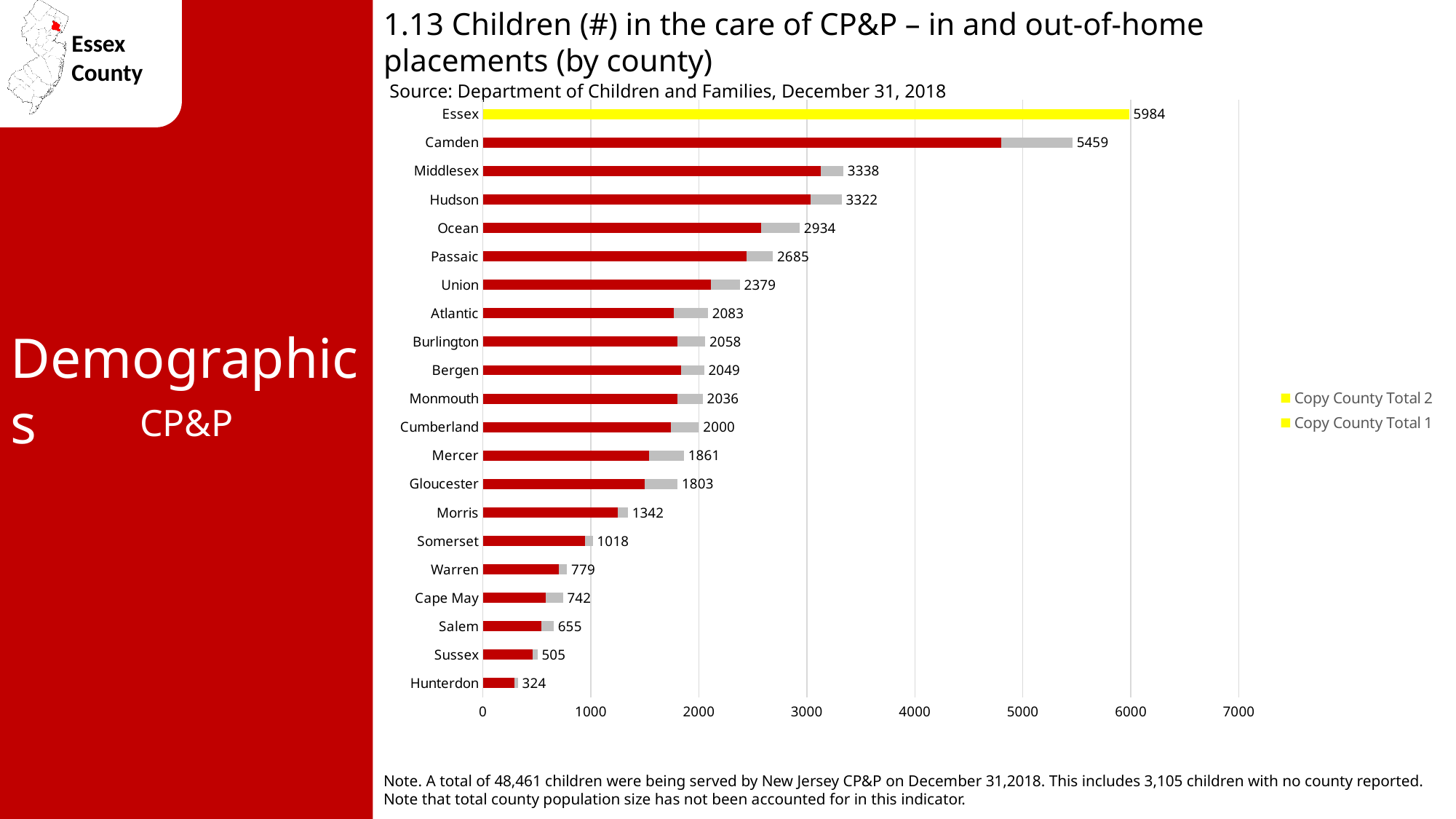
What is the difference between the totals for Essex and Camden? 525 Which county has the lowest total number of children in the care of CP&P? Hunterdon What is the total value shown for Camden County? 5459 What is the total number of children in the care of CP&P for Essex County? 5984 Is the total for Union County greater or less than 2000? greater Which county has a larger total, Ocean or Passaic? Ocean What is the difference between the totals for Middlesex and Hudson? 16 How many entries does the chart legend list? 2 How many counties are shown in the chart? 21 What is the total value shown for Hunterdon County? 324 Which county has the highest total number of children in the care of CP&P? Essex What type of chart is used on this slide? Bar chart